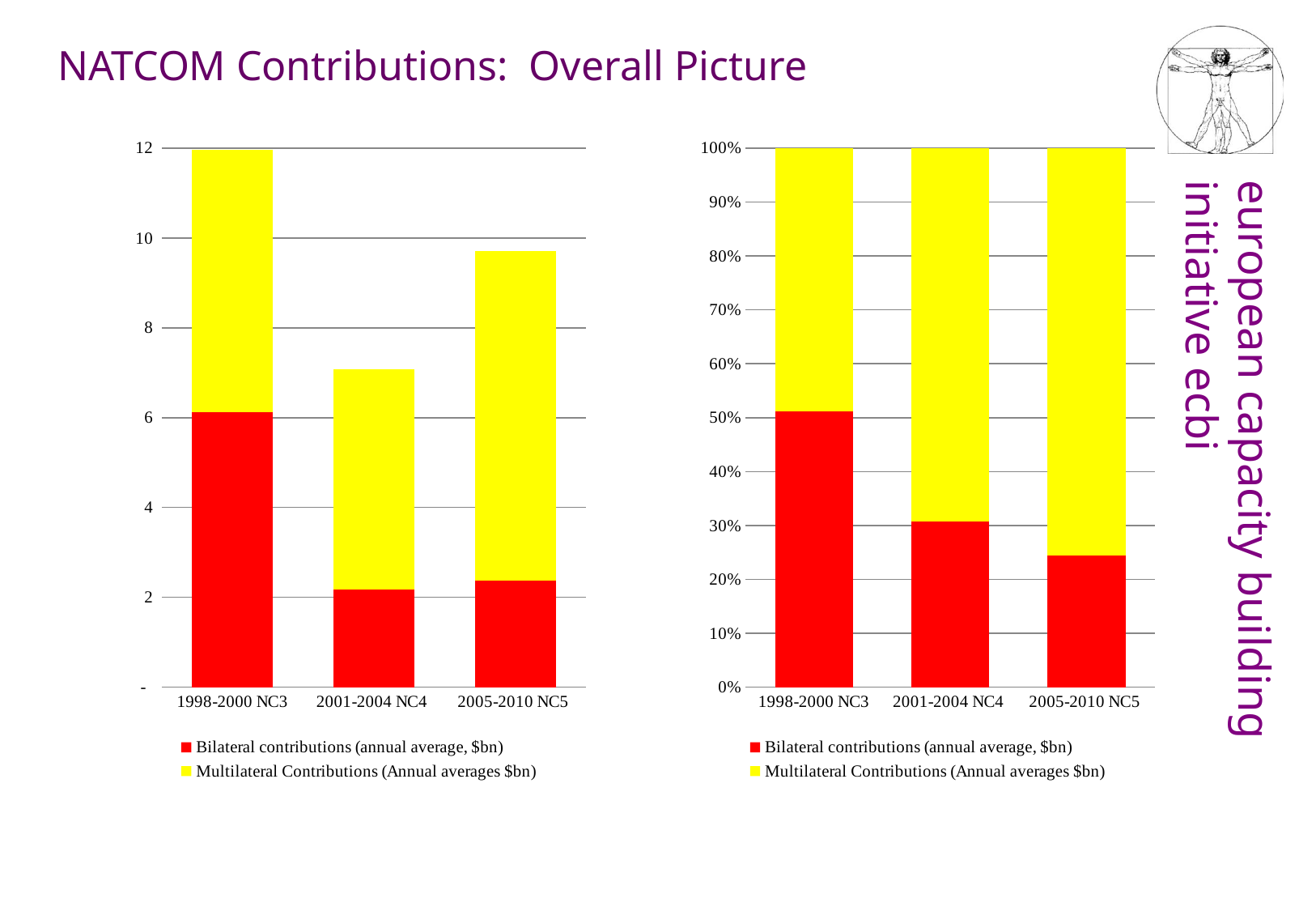
In the right chart, is the bilateral share for 2005-2010 NC5 greater or less than 30%? less In the right chart, which period has the largest bilateral share? 1998-2000 NC3 In the left chart, which period has the tallest stacked bar overall? 1998-2000 NC3 In the left chart, is the total stacked bar for 2005-2010 NC5 greater or less than 8? greater In the left chart, which period has the shortest stacked bar overall? 2001-2004 NC4 How many categories are shown on the x axis of the left chart? 3 How many series does the legend of the right chart list? 2 What kind of chart is the left chart on the slide? stacked bar chart In the left chart, which colour represents Multilateral Contributions? yellow In the left chart, is the bilateral contribution for 1998-2000 NC3 greater or less than 4? greater In the right chart, does the bilateral share rise or fall from 1998-2000 NC3 to 2005-2010 NC5? fall